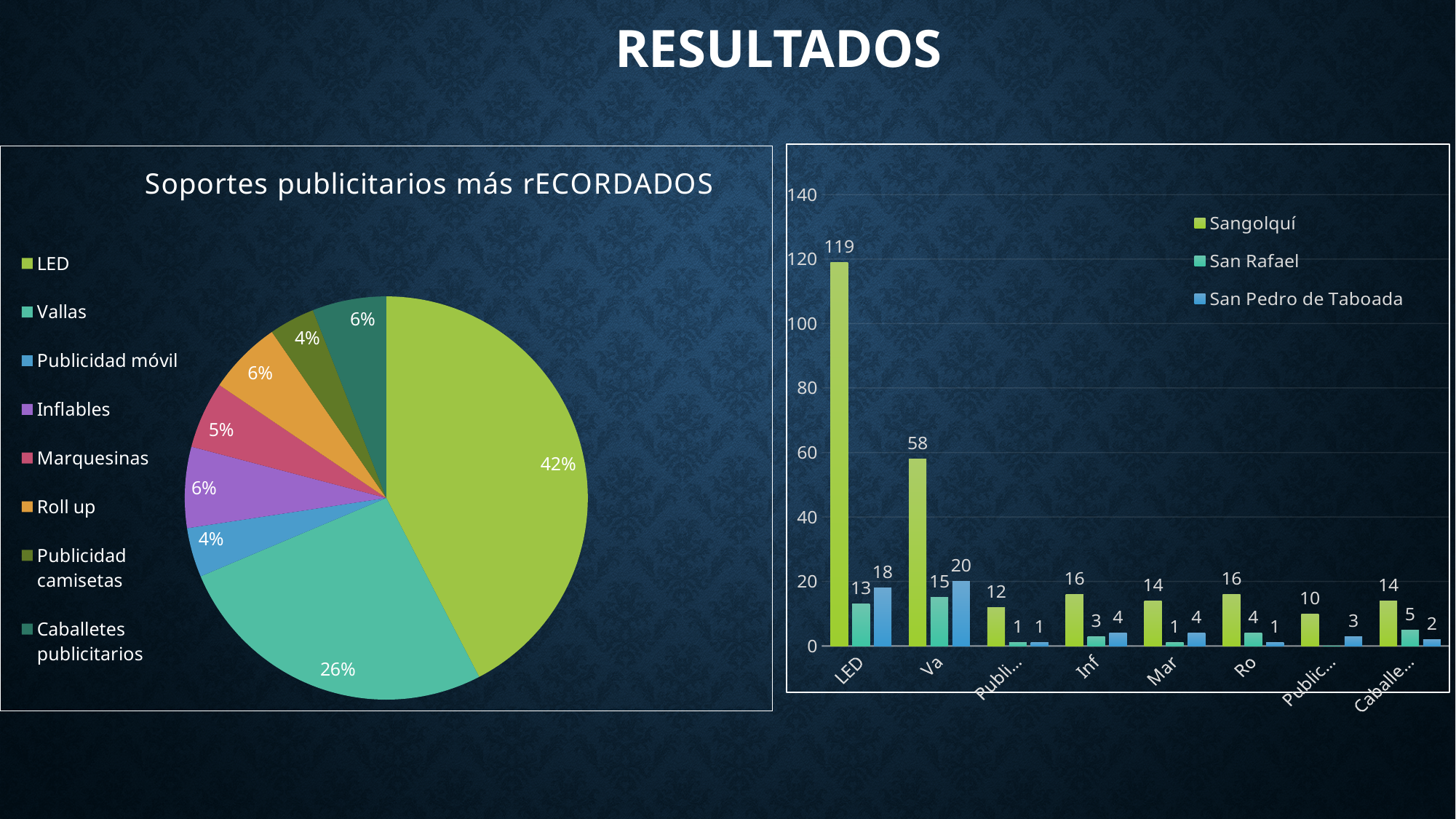
On the pie chart 'Soportes publicitarios más rECORDADOS', what is the difference between the LED share and the Vallas share? 16% On the bar chart on the right, what kind of chart is shown? Bar chart On the pie chart 'Soportes publicitarios más rECORDADOS', how many categories does the legend list? 8 On the pie chart 'Soportes publicitarios más rECORDADOS', what share does Vallas have? 26% On the bar chart on the right, what is the difference between the Sangolquí values for LED and for Va? 61 On the bar chart on the right, what is the value for Sangolquí in the LED category? 119 On the pie chart 'Soportes publicitarios más rECORDADOS', which category has the largest slice? LED On the bar chart on the right, what is the value for San Pedro de Taboada in the LED category? 18 On the pie chart 'Soportes publicitarios más rECORDADOS', what share does Marquesinas have? 5% On the bar chart on the right, how many series does the legend list? 3 On the bar chart on the right, which is larger in the LED category: San Rafael or San Pedro de Taboada? San Pedro de Taboada On the pie chart 'Soportes publicitarios más rECORDADOS', what share does LED have? 42%